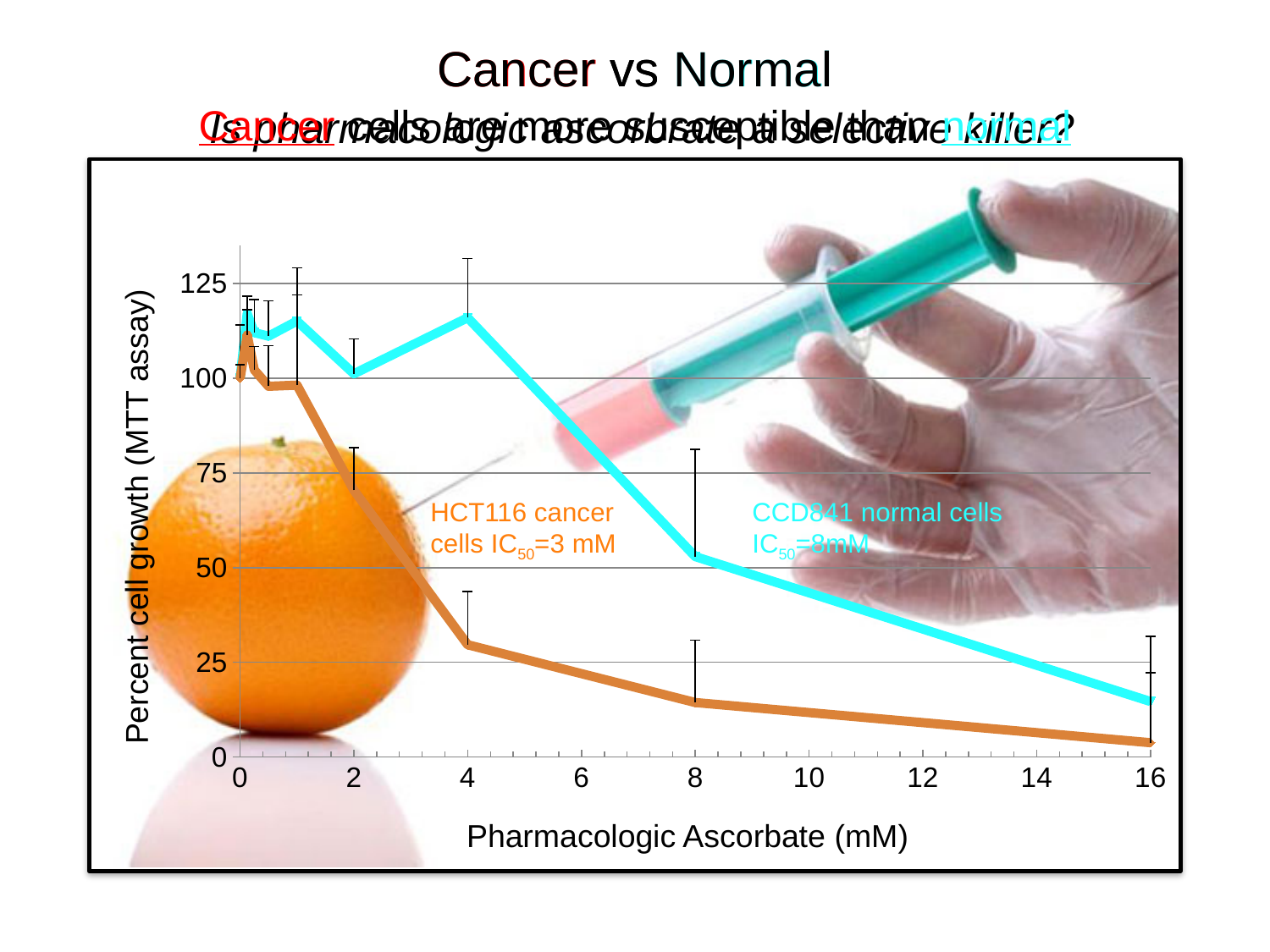
What is the title of the y axis? Percent cell growth (MTT assay) Is the percent cell growth for CCD841 normal cells at 16 mM greater or less than 25? less At 8 mM pharmacologic ascorbate, which cell line shows higher percent cell growth, HCT116 cancer cells or CCD841 normal cells? CCD841 normal cells Is the percent cell growth for CCD841 normal cells at 4 mM greater or less than 100? greater How many cell lines (series) are plotted on the chart? 2 Is the percent cell growth for HCT116 cancer cells at 8 mM greater or less than 25? less Does percent cell growth for HCT116 cancer cells rise or fall as pharmacologic ascorbate increases from 2 mM to 16 mM? fall Does percent cell growth for CCD841 normal cells rise or fall as pharmacologic ascorbate increases from 4 mM to 16 mM? fall At 16 mM pharmacologic ascorbate, which cell line shows higher percent cell growth, HCT116 cancer cells or CCD841 normal cells? CCD841 normal cells What kind of chart is shown on the slide? line chart What is the title of the x axis? Pharmacologic Ascorbate (mM) How many labelled tick marks are on the x axis? 9